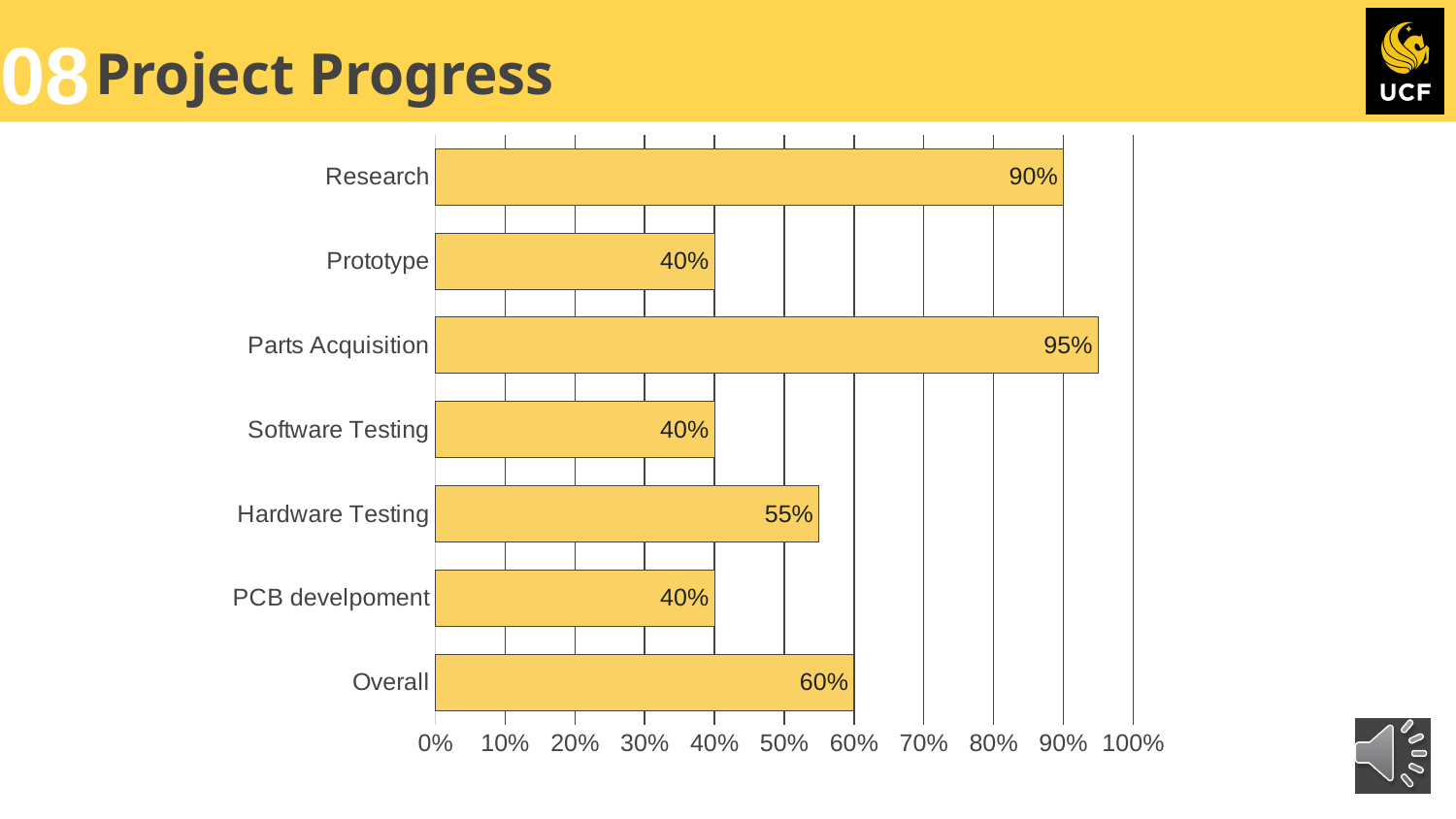
Is the value for Overall greater or less than 50%? greater What kind of chart is shown on the slide? bar chart What is the difference between the values for Parts Acquisition and Research? 5% What is the value for Hardware Testing? 55% What is the value for Overall? 60% What is the difference between the values for Overall and Hardware Testing? 5% Which is larger, the value for Hardware Testing or the value for Software Testing? Hardware Testing Which category has the highest value? Parts Acquisition How many categories have a value of 40%? 3 What is the value for Parts Acquisition? 95% How many categories are shown in the chart? 7 What is the value for Research? 90%